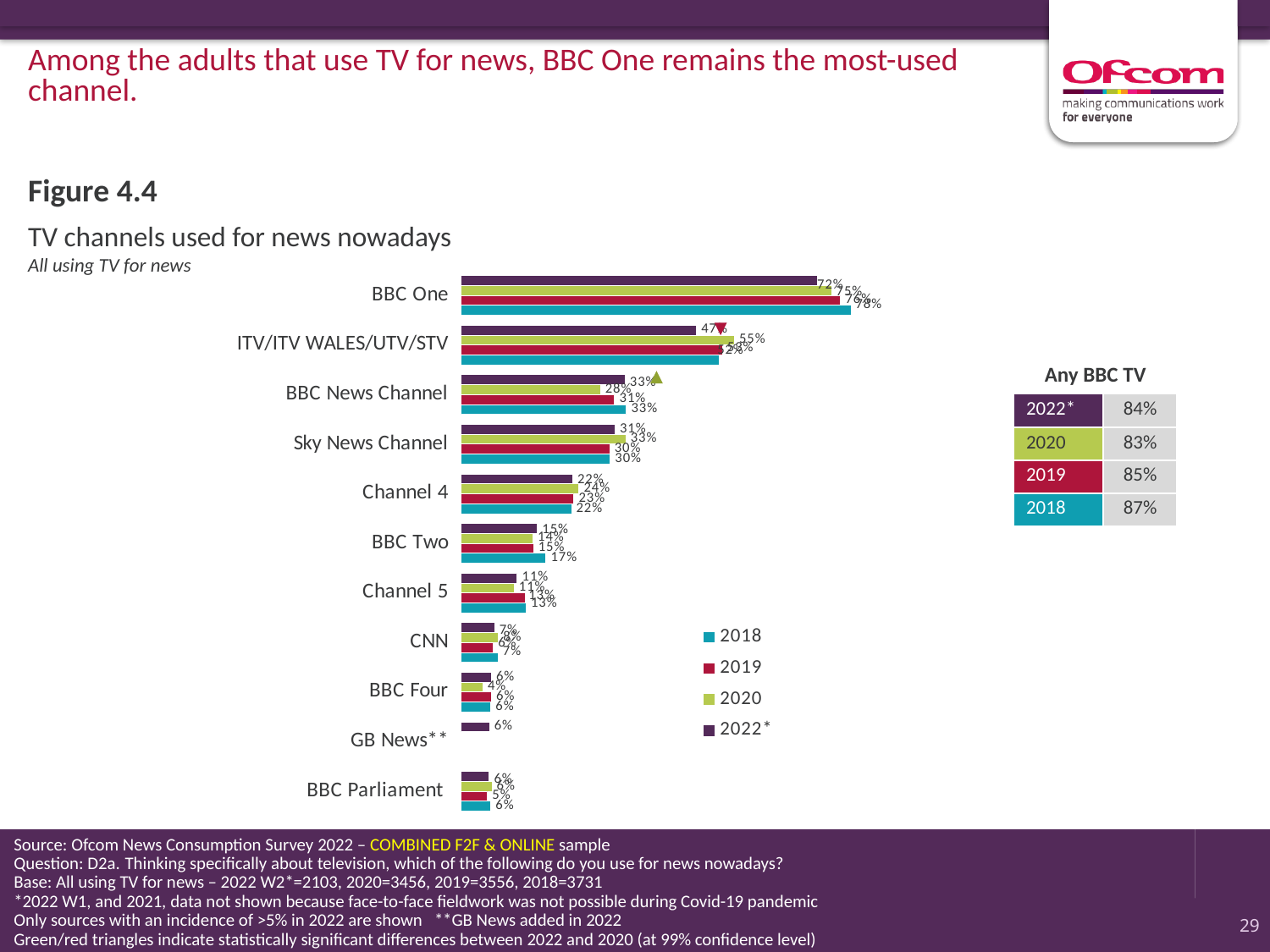
What is the 2020 value for BBC News Channel? 28% How many TV channels are listed as categories in the chart? 11 Which channel in the chart has a bar only for 2022*? GB News** What percentage of adults used BBC One for news in 2022*? 72% In the Any BBC TV table, what is the value for 2018? 87% What is the 2020 value for ITV/ITV WALES/UTV/STV? 55% What kind of chart is used to show TV channels used for news nowadays? Bar chart By how many percentage points did the ITV/ITV WALES/UTV/STV value fall from 2020 to 2022*? 8 percentage points How many series does the legend of the TV channels chart list? 4 Which TV channel has the highest 2022* value in the chart? BBC One What is the 2022* value for ITV/ITV WALES/UTV/STV? 47% What percentage of adults used BBC One for news in 2018? 78%